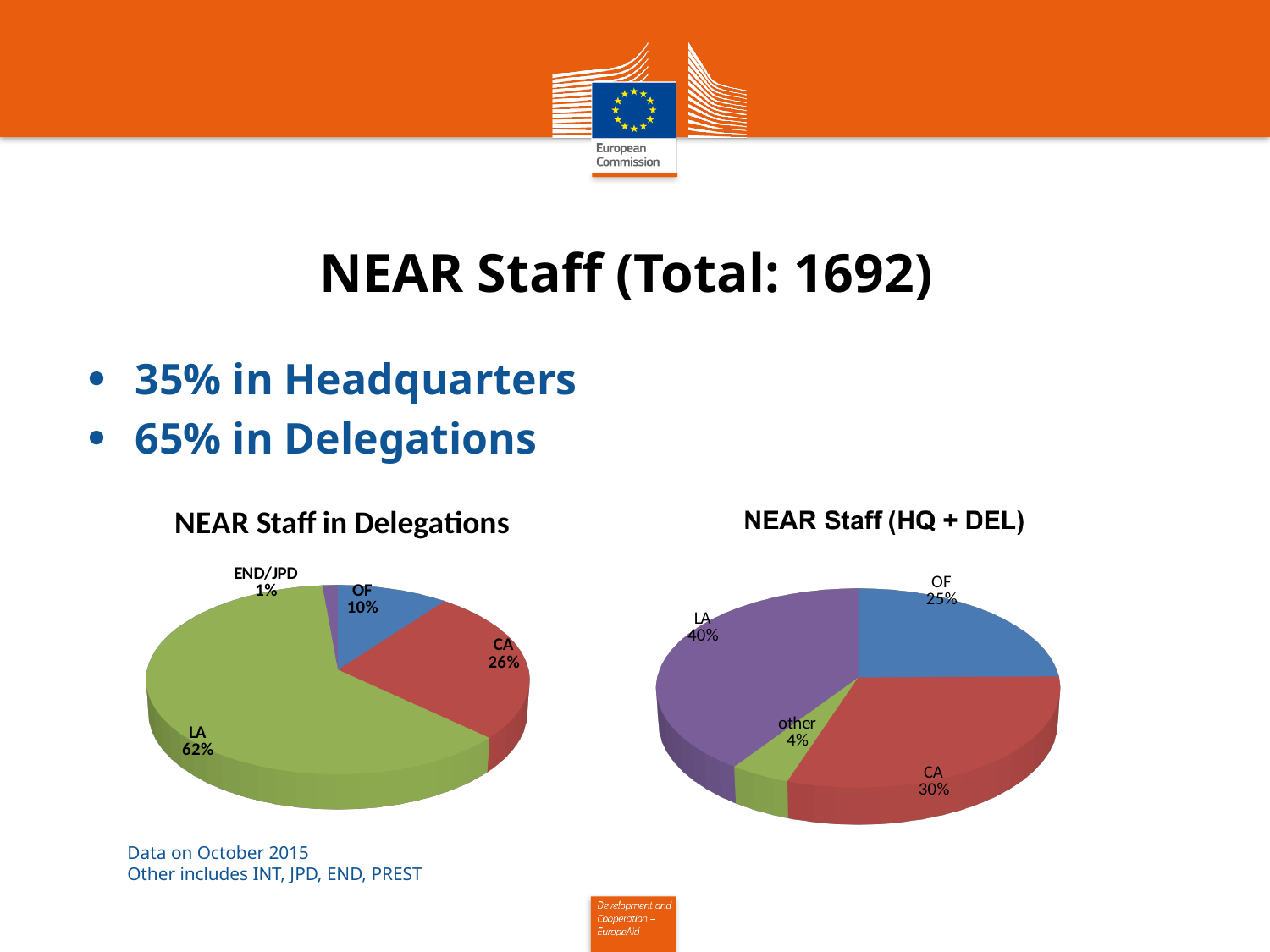
What type of chart is 'NEAR Staff in Delegations'? Pie chart In the 'NEAR Staff in Delegations' chart, which is larger, the OF share or the CA share? CA In the 'NEAR Staff in Delegations' chart, what share of staff is CA? 26% How many categories are shown in the 'NEAR Staff (HQ + DEL)' chart? 4 In the 'NEAR Staff in Delegations' chart, what share of staff is END/JPD? 1% In the 'NEAR Staff (HQ + DEL)' chart, which category has the smallest share? other In the 'NEAR Staff (HQ + DEL)' chart, what share of staff is OF? 25% In the 'NEAR Staff (HQ + DEL)' chart, what colour is the LA slice? Purple In the 'NEAR Staff (HQ + DEL)' chart, what share of staff is 'other'? 4% In the 'NEAR Staff (HQ + DEL)' chart, what is the difference between the LA share and the CA share? 10% In the 'NEAR Staff in Delegations' chart, which category has the largest share? LA In the 'NEAR Staff in Delegations' chart, what share of staff is LA? 62%